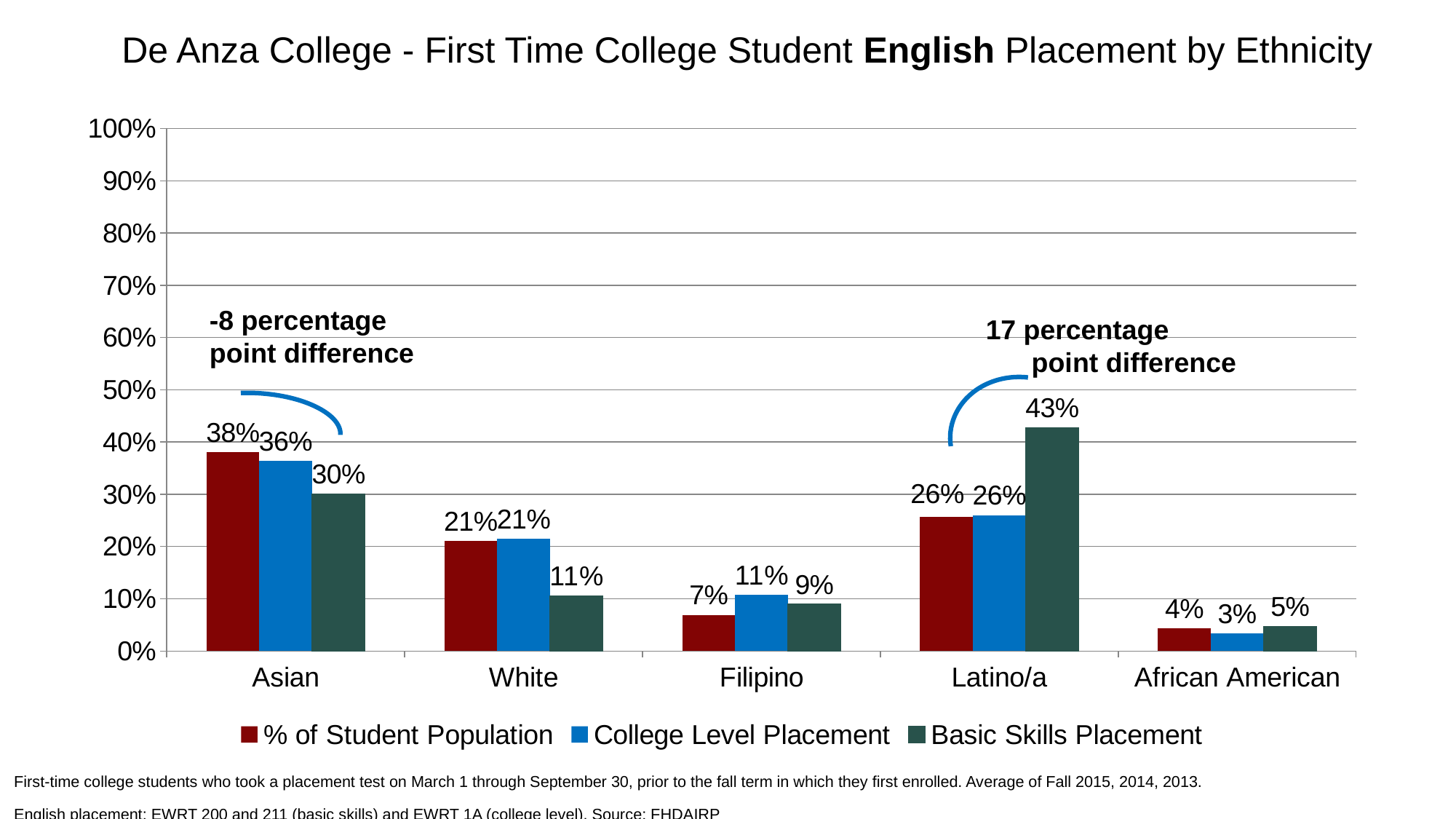
What is the title of the chart? De Anza College - First Time College Student English Placement by Ethnicity Which ethnicity has the lowest % of Student Population value? African American Which ethnicity has the highest Basic Skills Placement value? Latino/a Which is larger for Asian: the % of Student Population or the Basic Skills Placement? % of Student Population What kind of chart is shown on the slide? Bar chart How many ethnicity categories are shown on the x axis? 5 What is the College Level Placement value for Asian? 36% What is the % of Student Population value for Filipino? 7% What is the College Level Placement value for African American? 3% What is the difference between the Basic Skills Placement and College Level Placement values for Latino/a? 17% How many series does the legend list? 3 What is the Basic Skills Placement value for Latino/a? 43%